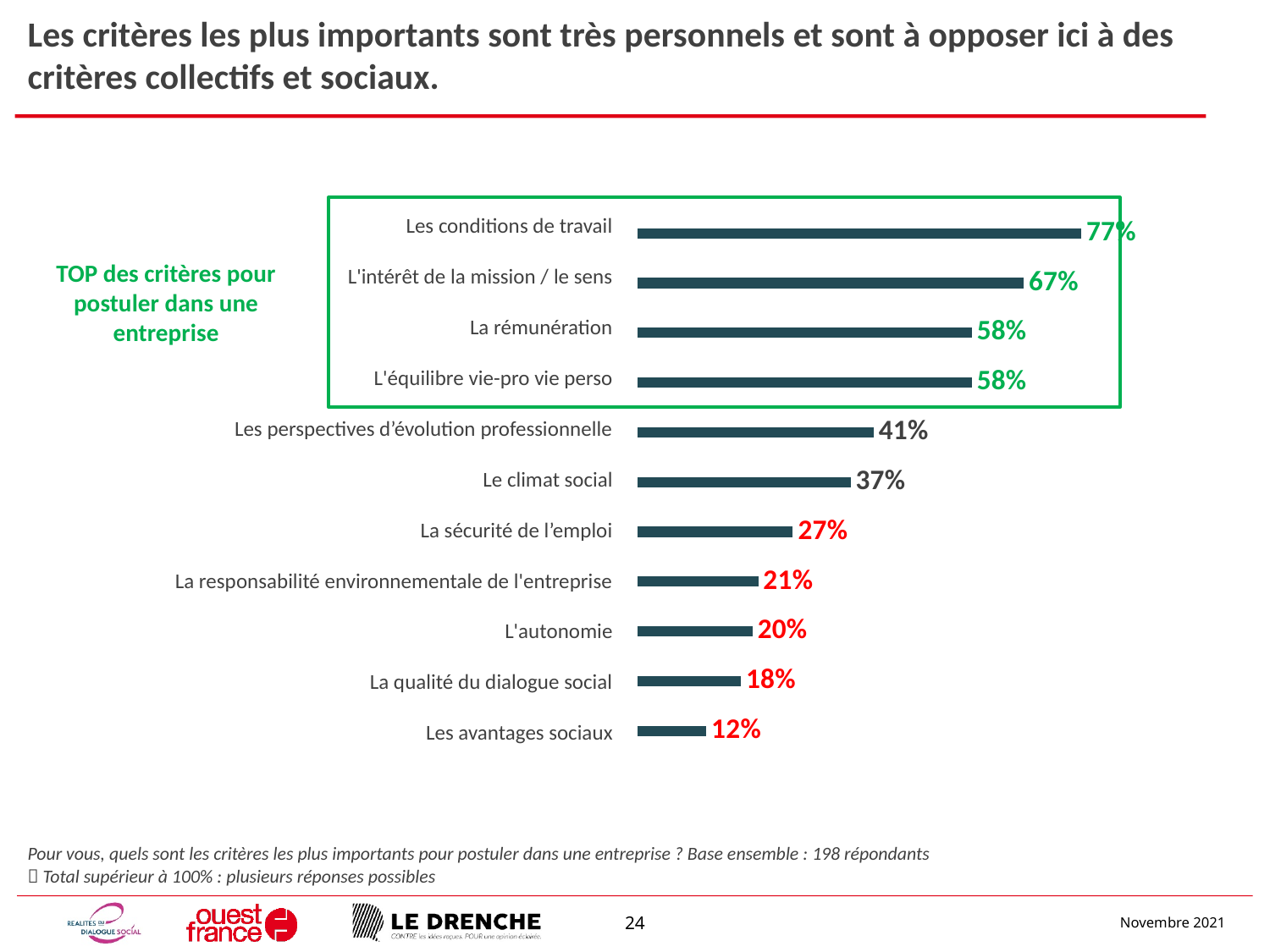
Which two categories share the same value of 58%? La rémunération and L'équilibre vie-pro vie perso How many categories are shown in the chart? 11 Which is larger, 'La sécurité de l'emploi' or 'L'autonomie'? La sécurité de l'emploi What is the value for 'Les conditions de travail'? 77% Which category has the lowest value? Les avantages sociaux What is the difference between 'L'intérêt de la mission / le sens' and 'La rémunération'? 9% What is the value for 'Le climat social'? 37% What is the difference between 'Les perspectives d'évolution professionnelle' and 'Les avantages sociaux'? 29% Which category has the highest value? Les conditions de travail How many categories are enclosed in the green box labelled 'TOP des critères pour postuler dans une entreprise'? 4 What kind of chart is shown on the slide? Bar chart What is the value for 'La qualité du dialogue social'? 18%